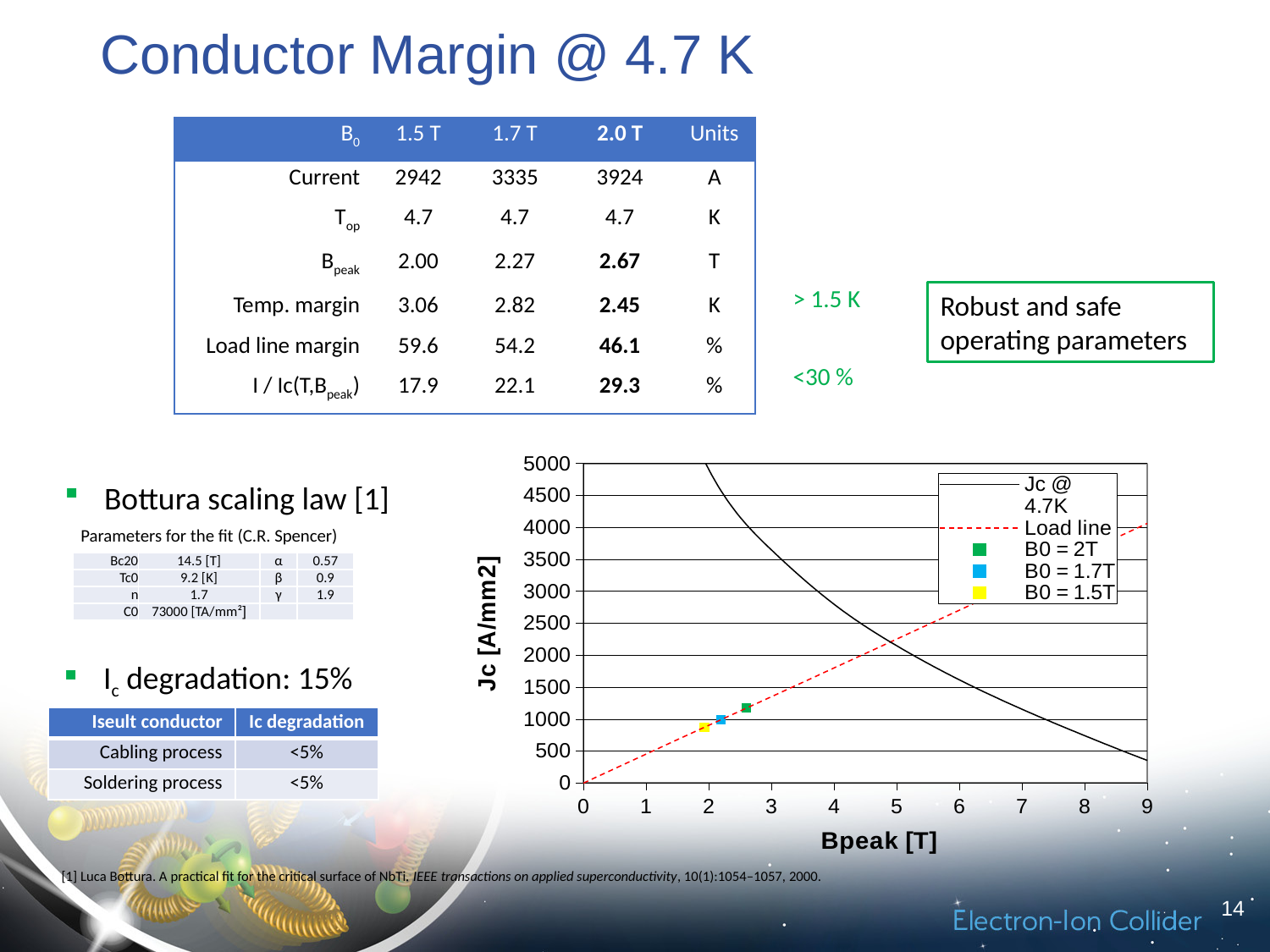
What is the highest tick value shown on the y axis of the chart? 5000 Which marker has the higher Jc value, B0 = 2T or B0 = 1.5T? B0 = 2T Does the Load line rise or fall as Bpeak increases? rise How many entries does the legend of the Jc vs Bpeak chart list? 5 What is the label of the y axis of the chart? Jc [A/mm2] Is the Jc value of the B0 = 1.5T marker greater or less than 1000? less What kind of chart is shown at the bottom right of the slide? line chart Is the Jc value of the B0 = 2T marker greater or less than 1000? greater Which of the three B0 markers lies at the lowest Bpeak? B0 = 1.5T Does the Jc @ 4.7K curve rise or fall as Bpeak increases? fall What is the label of the x axis of the chart? Bpeak [T] Is the Jc value of the B0 = 2T marker greater or less than 1500? less